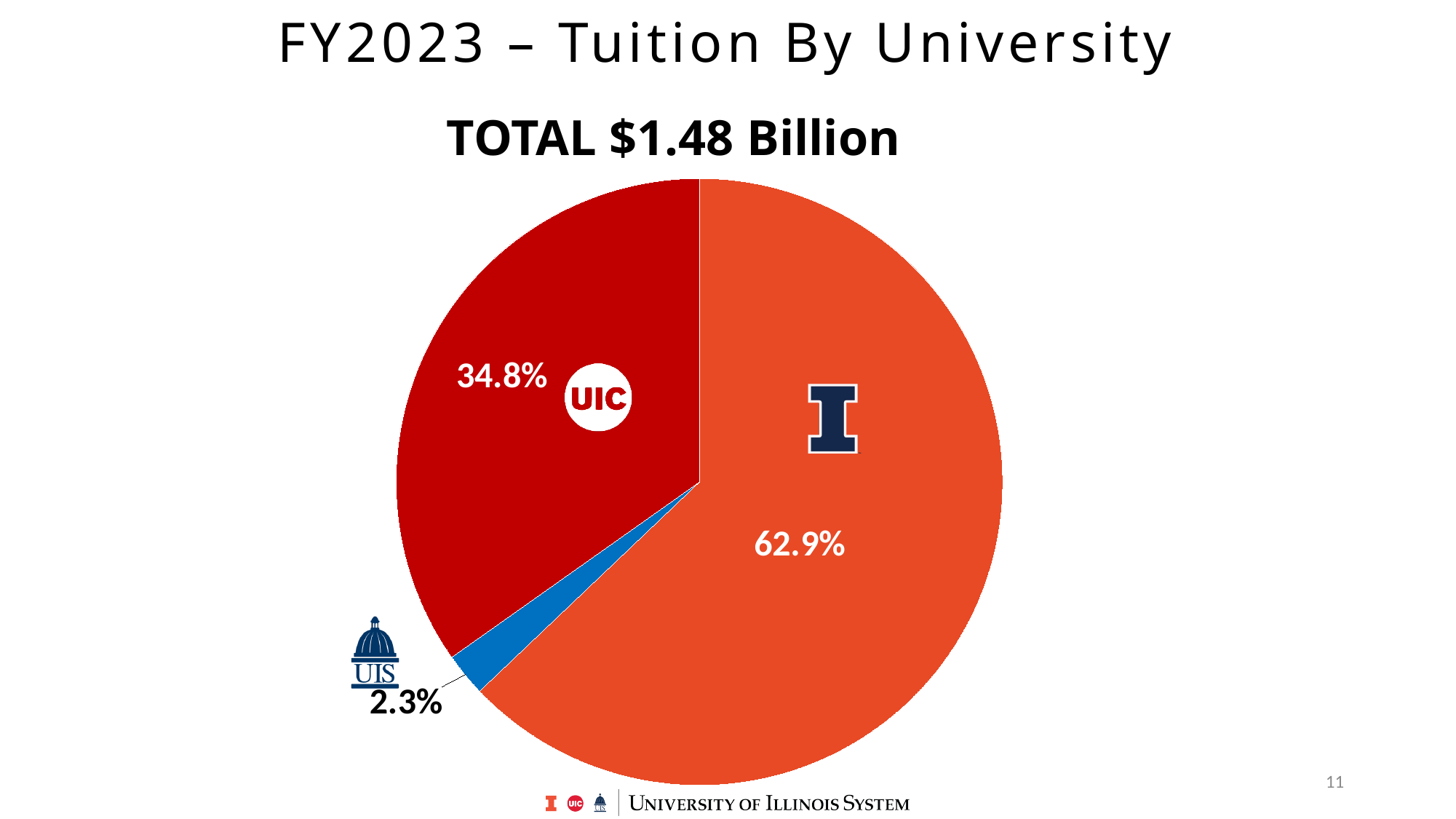
Which university has the smallest share of tuition in the pie chart? UIS What is the difference in percentage points between the largest slice (62.9%) and the UIC slice? 28.1 percentage points What total amount is stated above the pie chart? $1.48 Billion What kind of chart is shown on the slide? pie chart How many slices does the pie chart have? 3 Which is larger, the UIC share or the UIS share? UIC What share of tuition does the UIS slice represent? 2.3% What is the title of the slide? FY2023 – Tuition By University What is the difference in percentage points between the UIC share and the UIS share? 32.5 percentage points What share of tuition does the orange slice with the Block I logo represent? 62.9% Which slice of the pie is the largest? the orange slice with the Block I logo (62.9%) What share of tuition does the UIC slice represent? 34.8%